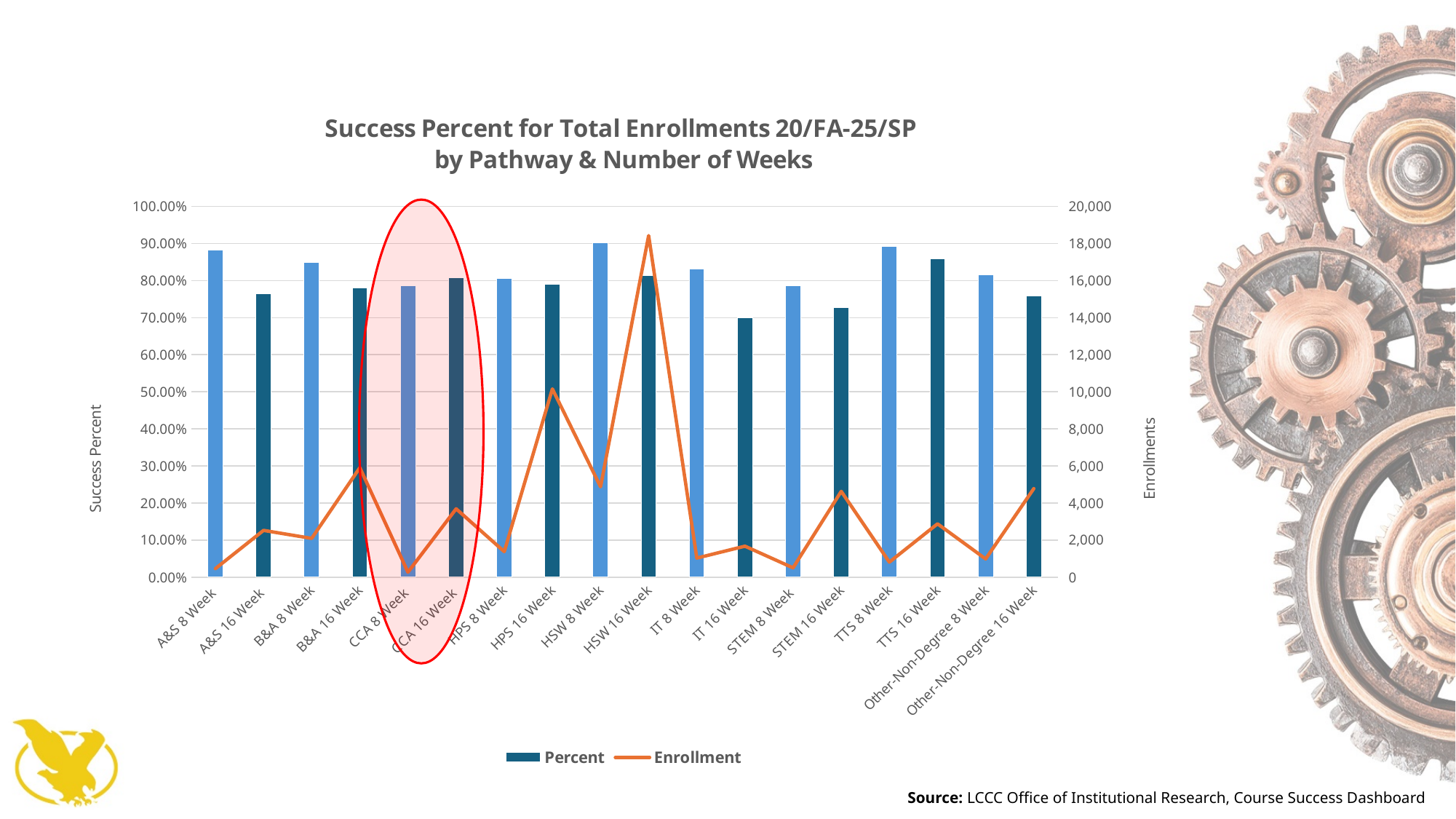
Which category has the lowest success Percent? IT 16 Week Is the Enrollment value for HSW 16 Week greater or less than 16,000? greater Is the Enrollment value for A&S 8 Week greater or less than 2,000? less Which two categories are highlighted with a red oval on the chart? CCA 8 Week and CCA 16 Week Which category has the highest Enrollment value? HSW 16 Week Which has the higher success Percent, A&S 8 Week or IT 16 Week? A&S 8 Week How many pathway/week categories are shown on the x axis? 18 Is the success Percent for IT 16 Week greater or less than 80.00%? less What type of chart is shown on the slide? A combined bar and line chart Which has the higher Enrollment, HSW 16 Week or HPS 16 Week? HSW 16 Week How many series does the legend list? 2